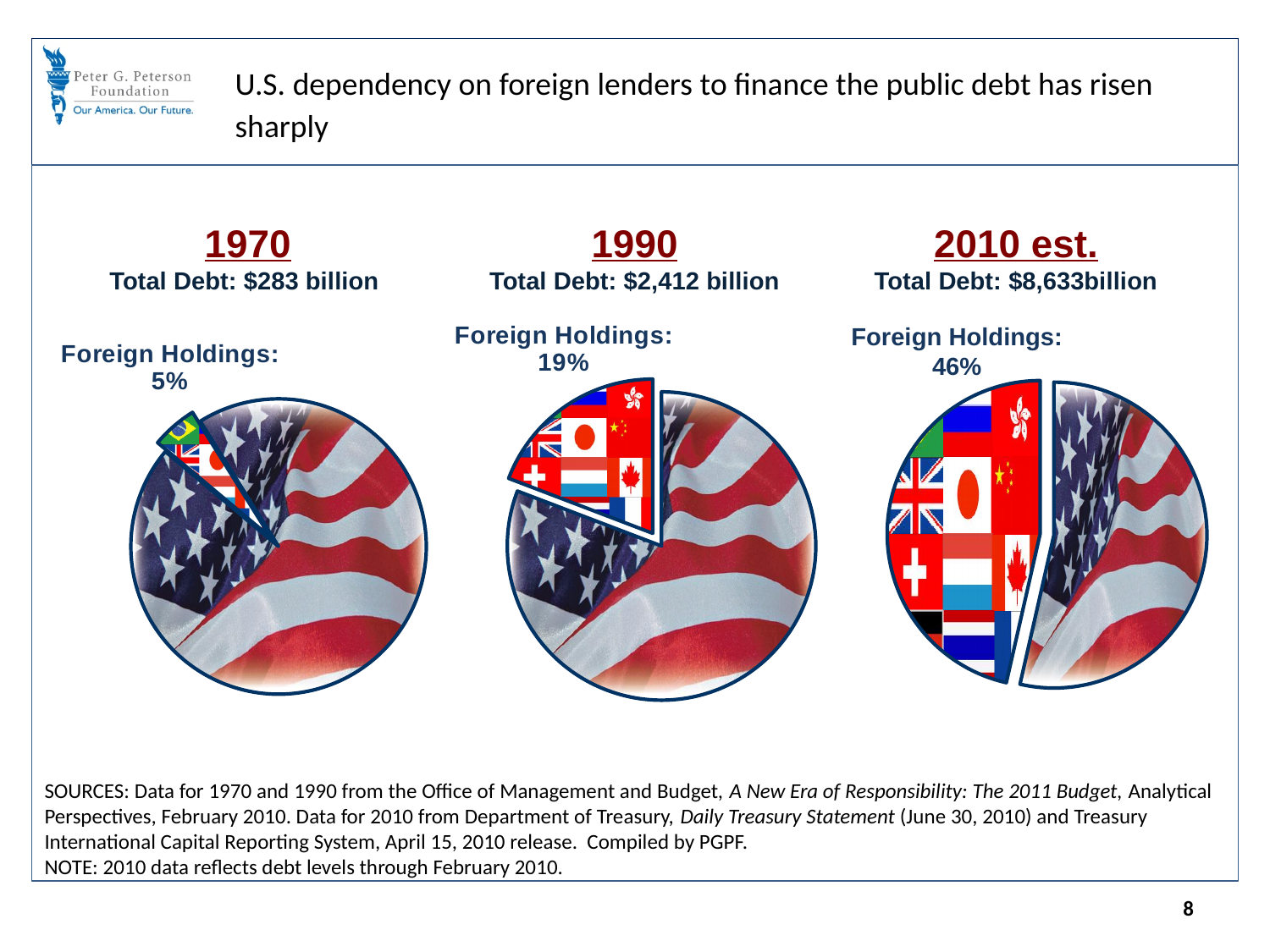
Does the foreign holdings share rise or fall from the 1970 chart to the 2010 est. chart? Rise In the 1970 pie chart, what share of the public debt is foreign holdings? 5% How many pie charts are on the slide? 3 What is the total debt shown for the 1970 pie chart? $283 billion In the 1990 pie chart, what share of the public debt is foreign holdings? 19% Which year's pie chart shows the smallest foreign holdings share? 1970 In the 2010 est. pie chart, what share of the public debt is foreign holdings? 46% What is the total debt shown for the 2010 est. pie chart? $8,633billion What kind of charts are shown on the slide? Pie charts By how many percentage points did the foreign holdings share increase from 1990 to 2010 est.? 27 percentage points What is the total debt shown for the 1990 pie chart? $2,412 billion Which year's pie chart shows the largest foreign holdings share? 2010 est.